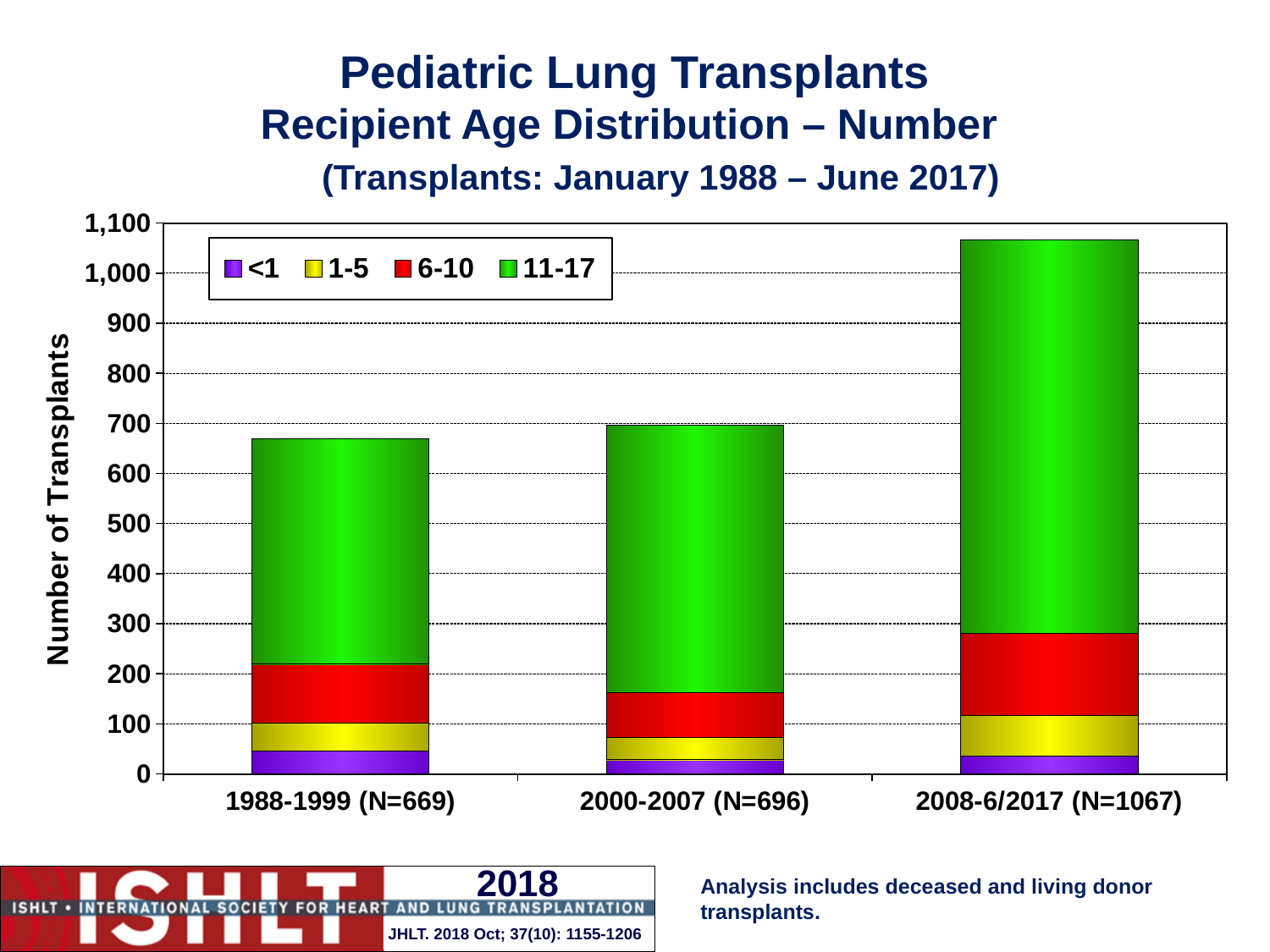
Do the total bar heights rise or fall from left to right across the time periods? Rise What kind of chart is shown on the slide? Stacked bar chart What is the difference in total transplants between 2008-6/2017 and 2000-2007? 371 How many age-group series does the legend list? 4 How many time-period categories are shown on the x axis? 3 Which has a larger total number of transplants, 1988-1999 or 2000-2007? 2000-2007 Is the value of the <1 age group segment for 2008-6/2017 greater or less than 100? less What is the total number of transplants for the 1988-1999 bar? 669 Which time period has the highest total number of transplants? 2008-6/2017 What is the total number of transplants for the 2008-6/2017 bar? 1067 Which time period has the lowest total number of transplants? 1988-1999 Which age group is shown in green in the legend? 11-17